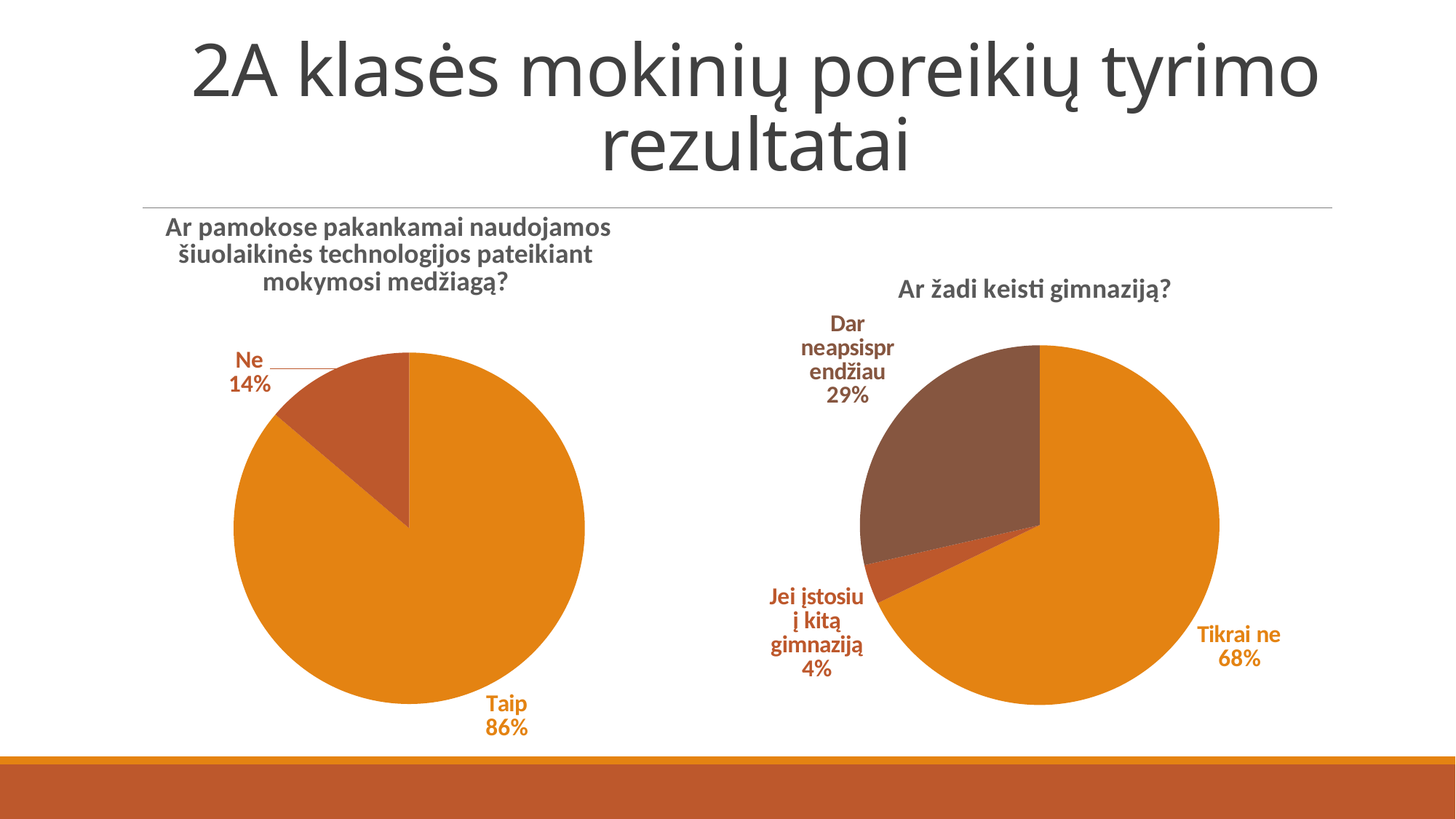
In the left chart ("Ar pamokose pakankamai naudojamos šiuolaikinės technologijos pateikiant mokymosi medžiagą?"), what share of the pie is "Taip"? 86% In the right chart, what share of the pie is "Jei įstosiu į kitą gimnaziją"? 4% How many slices does the right pie chart have? 3 In the left chart, which category has the largest slice? Taip In the right chart, which category has the smallest slice? Jei įstosiu į kitą gimnaziją In the left chart, what is the difference between the "Taip" and "Ne" shares? 72% What type of chart is used for "Ar žadi keisti gimnaziją?"? Pie chart In the right chart ("Ar žadi keisti gimnaziją?"), what share of the pie is "Tikrai ne"? 68% How many slices does the left pie chart have? 2 In the right chart, which is larger: "Tikrai ne" or "Dar neapsisprendžiau"? Tikrai ne